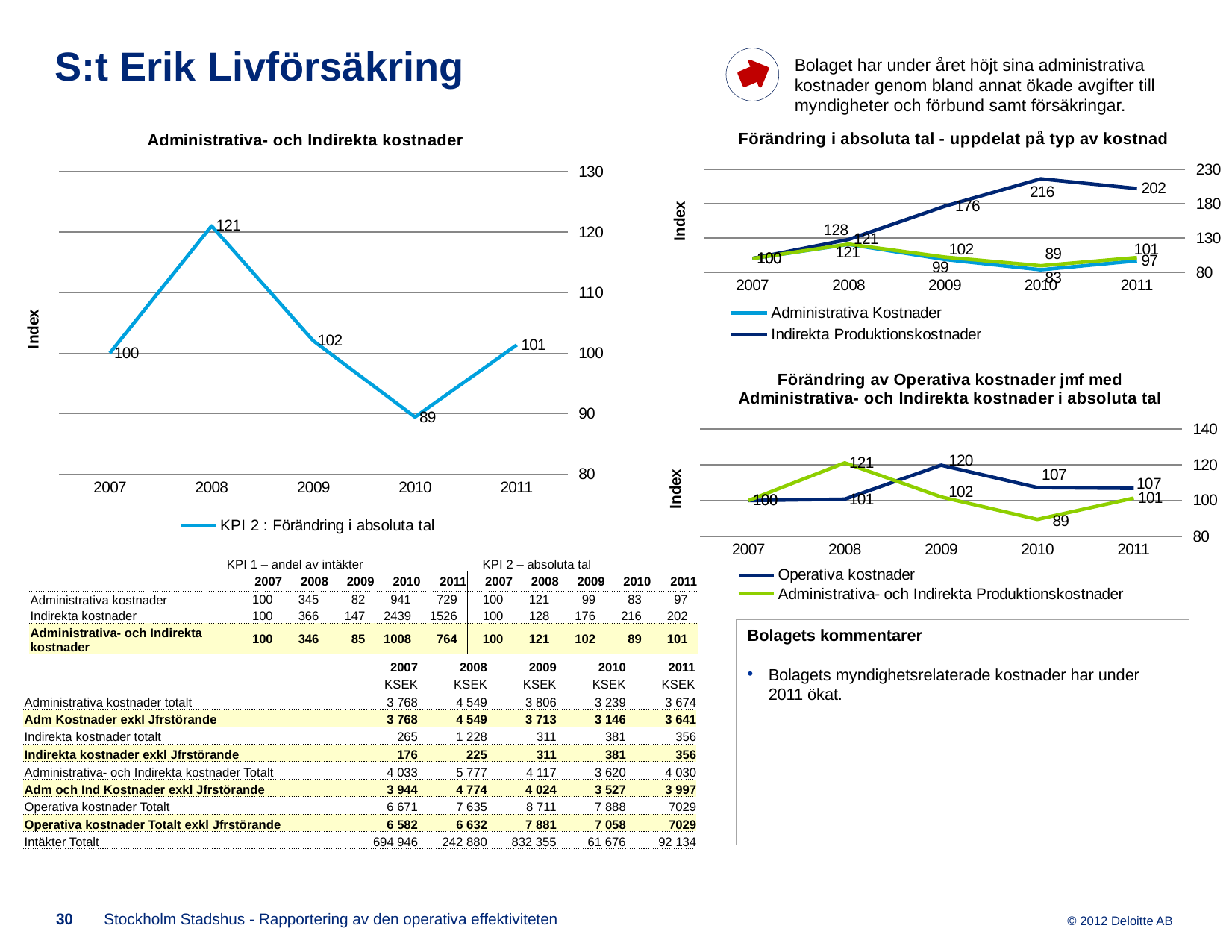
In the chart titled 'Förändring av Operativa kostnader jmf med Administrativa- och Indirekta kostnader i absoluta tal', what is the value for Operativa kostnader in 2009? 120 In the chart titled 'Förändring i absoluta tal - uppdelat på typ av kostnad', what is the value for Indirekta Produktionskostnader in 2010? 216 In the chart titled 'Förändring av Operativa kostnader jmf med Administrativa- och Indirekta kostnader i absoluta tal', which series has the larger value in 2008? Administrativa- och Indirekta Produktionskostnader In the chart titled 'Administrativa- och Indirekta kostnader', how many years are plotted on the x axis? 5 What type of chart is the chart titled 'Administrativa- och Indirekta kostnader'? Line chart In the chart titled 'Administrativa- och Indirekta kostnader', which year has the lowest value? 2010 In the chart titled 'Förändring i absoluta tal - uppdelat på typ av kostnad', which year has the highest value for Indirekta Produktionskostnader? 2010 In the chart titled 'Förändring av Operativa kostnader jmf med Administrativa- och Indirekta kostnader i absoluta tal', which year has the lowest value for Administrativa- och Indirekta Produktionskostnader? 2010 In the chart titled 'Förändring i absoluta tal - uppdelat på typ av kostnad', how many series does the legend list? 2 In the chart titled 'Administrativa- och Indirekta kostnader', what is the difference between the 2008 value and the 2010 value? 32 In the chart titled 'Administrativa- och Indirekta kostnader', what is the value for 2008? 121 In the chart titled 'Förändring i absoluta tal - uppdelat på typ av kostnad', what is the difference between Indirekta Produktionskostnader and Administrativa Kostnader in 2011? 105